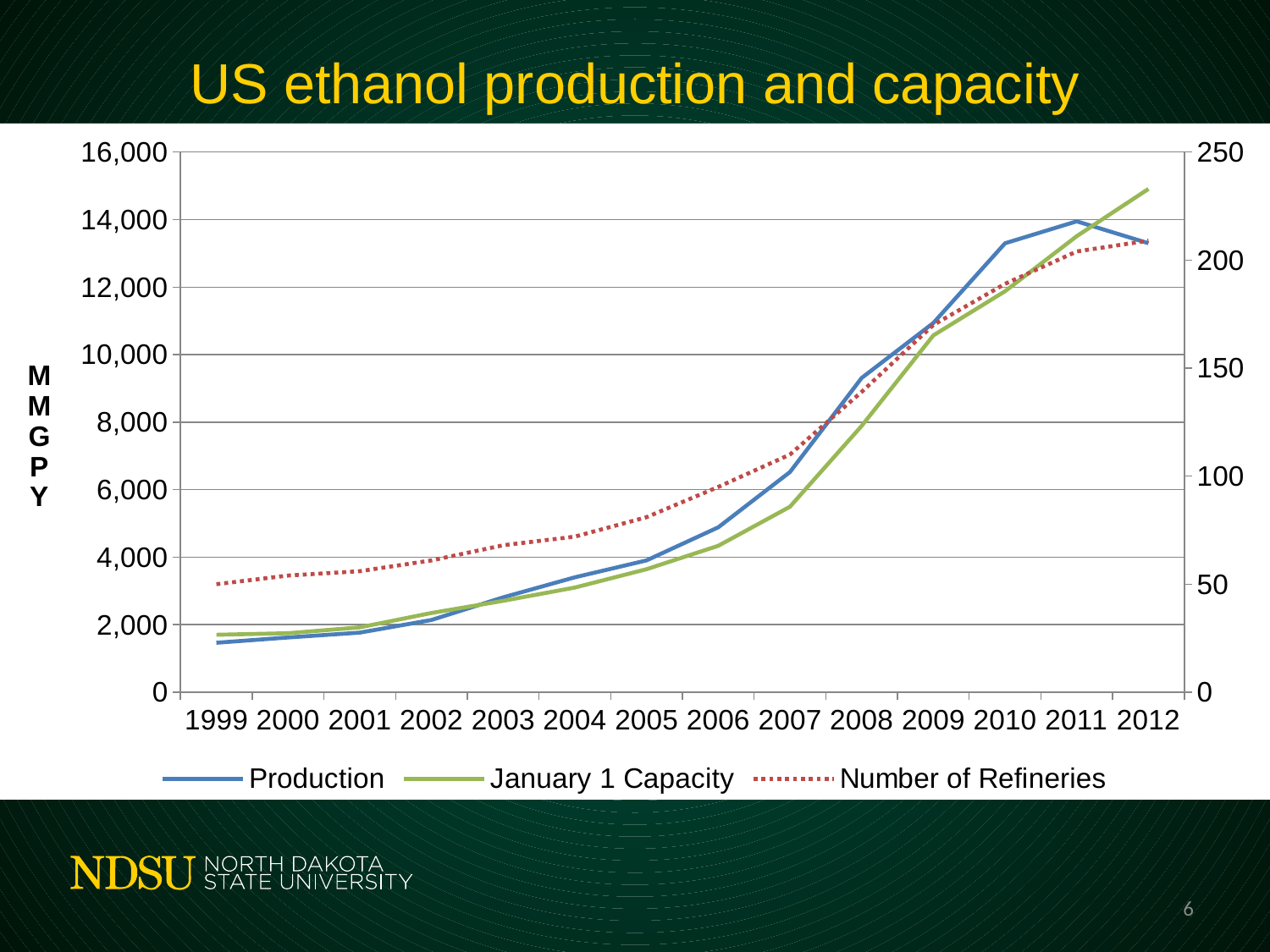
Is the January 1 Capacity value for 2007 greater or less than 6,000? less Which series is drawn as a dotted line? Number of Refineries In which year is January 1 Capacity at its highest? 2012 How many years are plotted along the x axis? 14 In which year is Production at its lowest? 1999 Does Production generally rise or fall from 1999 to 2011? rise What kind of chart is shown on the slide? line chart In 2012, which is larger: Production or January 1 Capacity? January 1 Capacity How many series does the legend list? 3 Is the Production value for 2010 greater or less than 12,000? greater In which year is Production at its highest? 2011 What is the title of the chart? US ethanol production and capacity